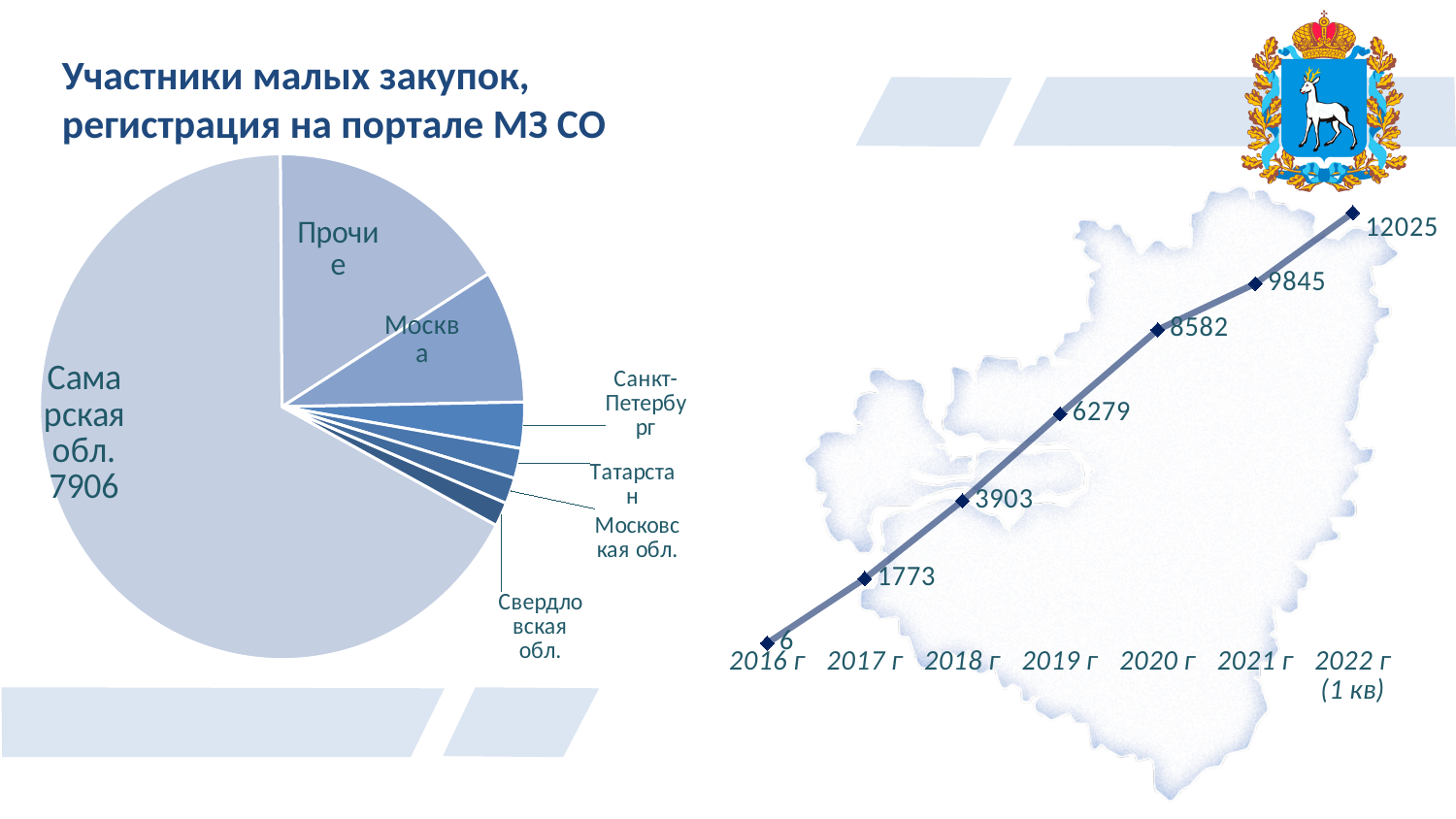
What is the title of the pie chart on the left? Участники малых закупок, регистрация на портале МЗ СО In the pie chart on the left, which slice is larger: Прочие or Москва? Прочие What kind of chart is the chart on the left of the slide? pie chart In the line chart on the right, what is the difference between the values for 2020 г and 2019 г? 2303 In the line chart on the right, what is the value for 2018 г? 3903 How many data points does the line chart on the right show? 7 In the line chart on the right, do the values rise or fall from 2016 г to 2022 г (1 кв)? rise How many categories does the pie chart on the left show? 7 In the line chart on the right, what is the value for 2022 г (1 кв)? 12025 In the pie chart on the left, what value is shown for Самарская обл.? 7906 In the pie chart on the left, which category has the largest slice? Самарская обл. What kind of chart is the chart on the right of the slide? line chart